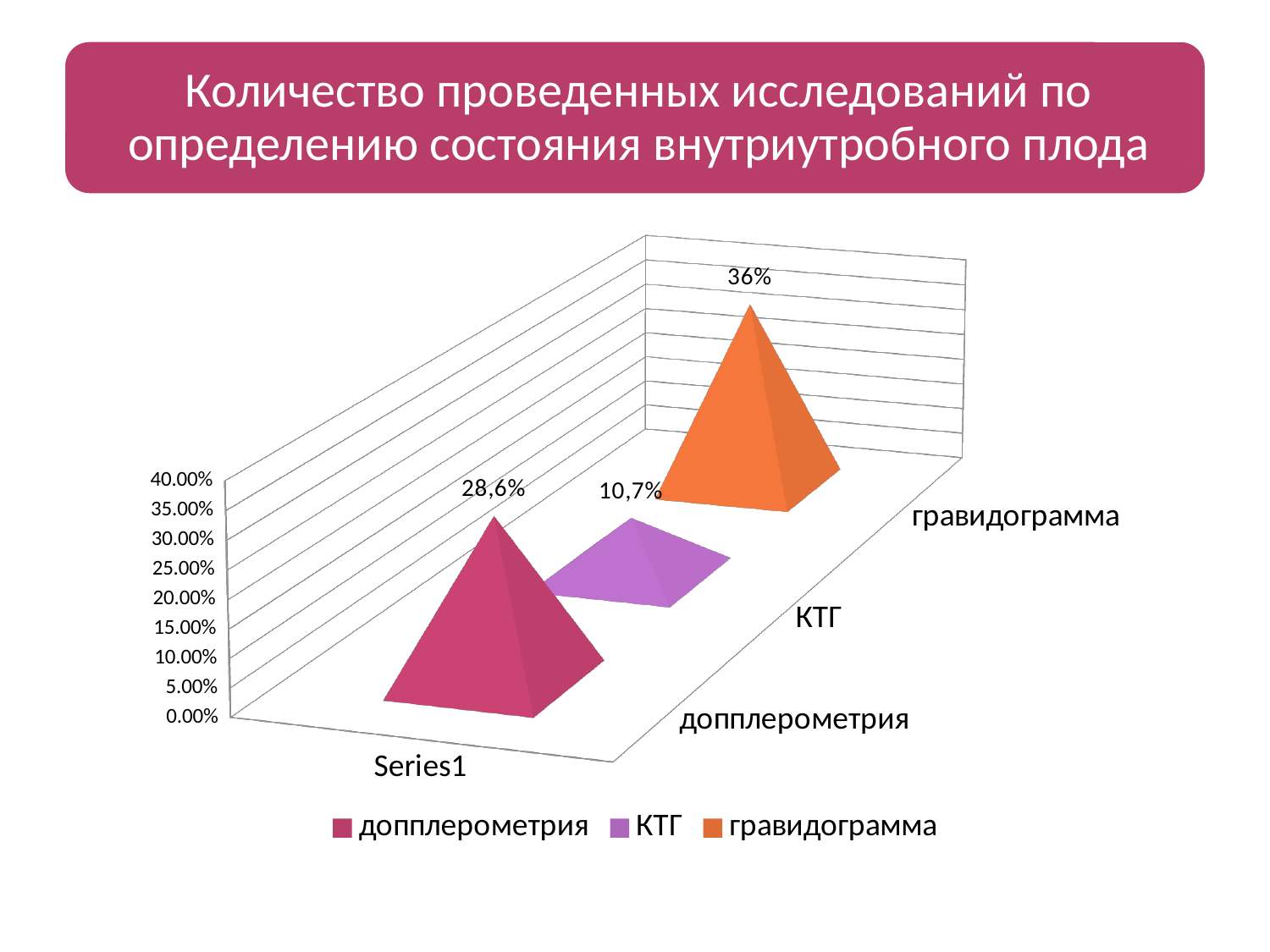
What is the difference between the values for допплерометрия and КТГ? 17,9% Which series has the highest value? гравидограмма What value is shown for гравидограмма? 36% How many series does the legend list? 3 Which series has the lowest value? КТГ Which is larger, the value for допплерометрия or the value for КТГ? допплерометрия What is the title of the slide? Количество проведенных исследований по определению состояния внутриутробного плода What value is shown for КТГ? 10,7% What kind of chart is shown on the slide? bar chart What value is shown for допплерометрия? 28,6% Is the value for гравидограмма greater or less than 30.00%? greater What is the difference between the values for гравидограмма and допплерометрия? 7,4%